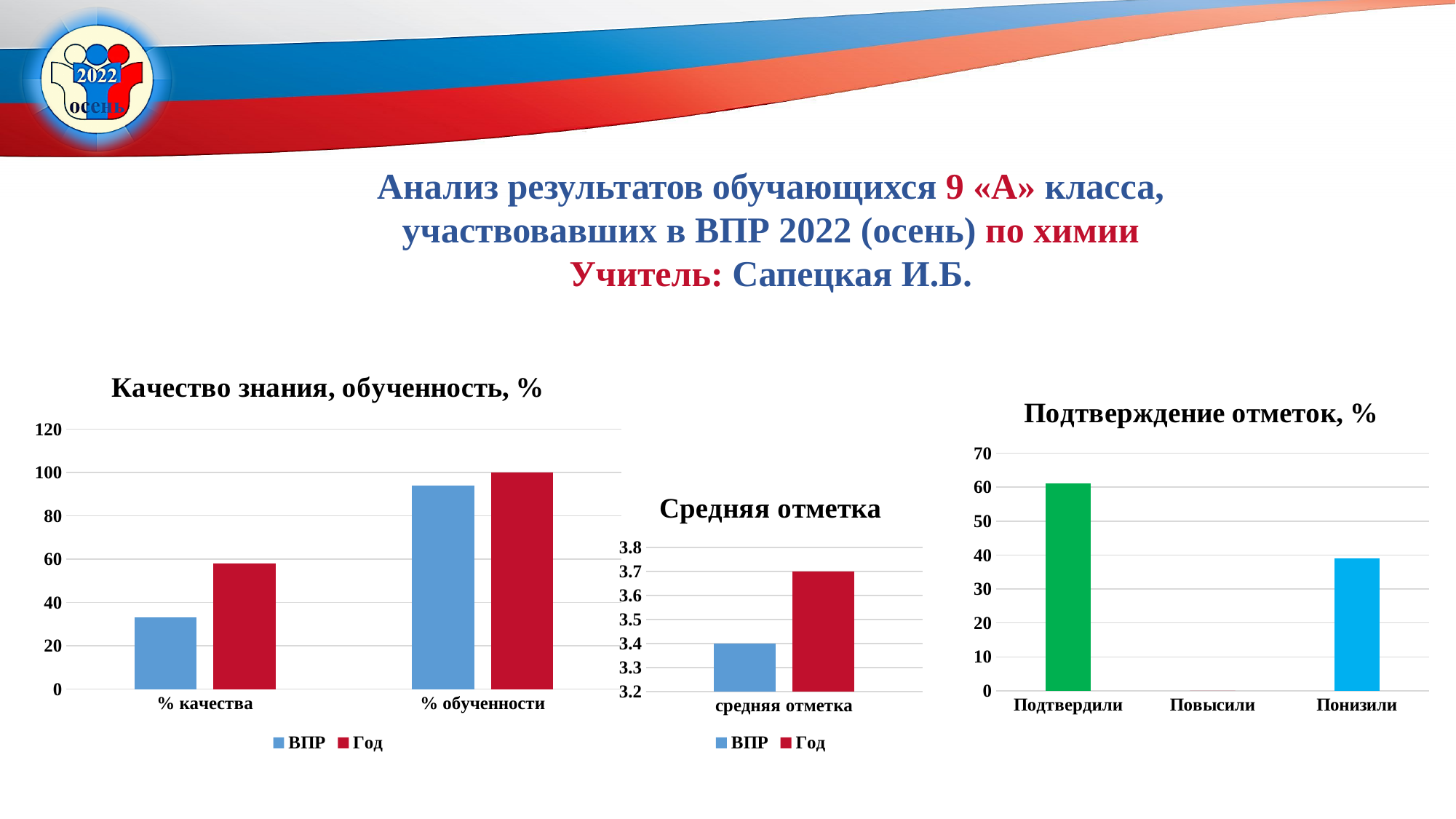
In the chart titled "Средняя отметка", what is the difference between the Год value and the ВПР value? 0.3 In the chart titled "Подтверждение отметок, %", is the value for Подтвердили greater or less than 50? greater In the chart titled "Качество знания, обученность, %", is the Год value for % качества greater or less than 40? greater In the chart titled "Средняя отметка", what is the value for Год? 3.7 In the chart titled "Средняя отметка", which series has the larger value, ВПР or Год? Год In the chart titled "Качество знания, обученность, %", what is the value of the Год series for % обученности? 100 In the chart titled "Подтверждение отметок, %", which category has the highest value? Подтвердили In the chart titled "Подтверждение отметок, %", which category has the lowest value? Повысили In the chart titled "Качество знания, обученность, %", which series has the larger value for % обученности, ВПР or Год? Год How many series does the legend of the chart titled "Качество знания, обученность, %" list? 2 In the chart titled "Средняя отметка", what is the value for ВПР? 3.4 In the chart titled "Качество знания, обученность, %", is the ВПР value for % качества greater or less than 40? less